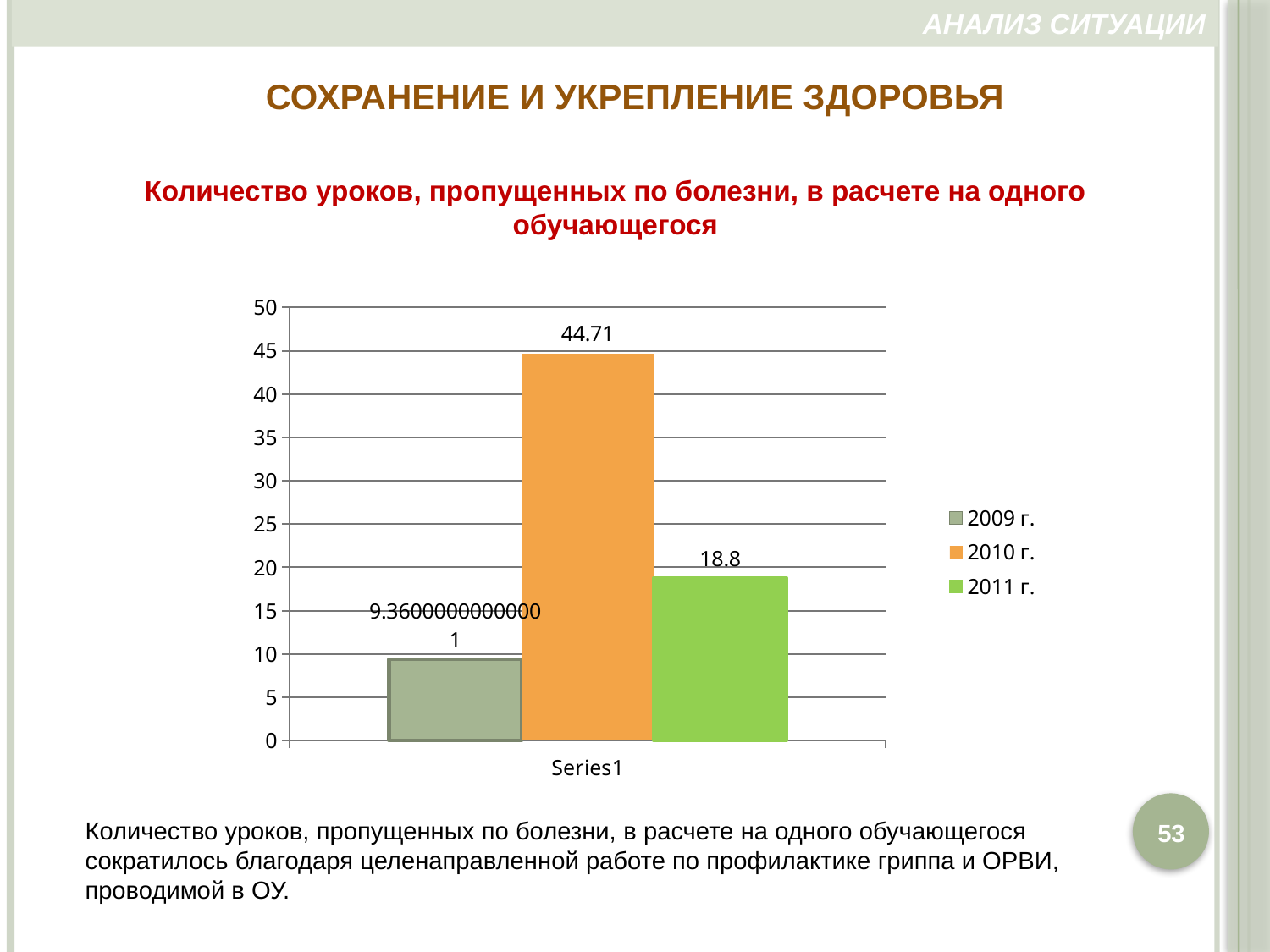
What is the difference between the values for 2010 г. and 2011 г.? 25.91 What kind of chart is shown on the slide? bar chart What colour is the bar for 2010 г.? orange Is the value for 2010 г. greater or less than 40? greater What is the value for 2010 г. in the chart? 44.71 Which is larger, the value for 2009 г. or the value for 2011 г.? 2011 г. What is the value for 2011 г. in the chart? 18.8 How many series does the legend list? 3 What is the label on the x axis under the bars? Series1 Which year has the lowest value in the chart? 2009 г. Which year has the highest value in the chart? 2010 г. Is the value for 2009 г. greater or less than 15? less